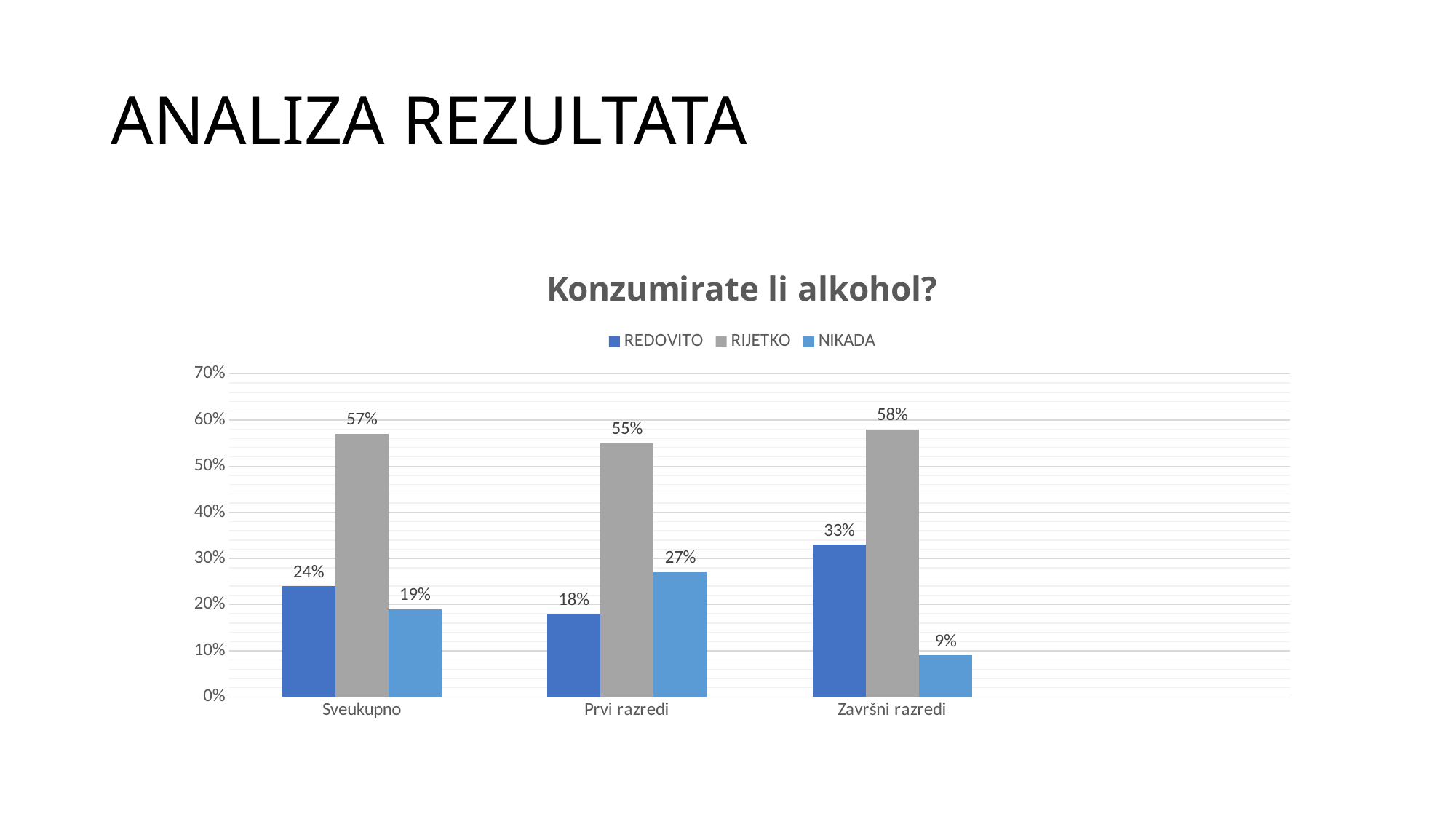
What is the difference between the REDOVITO values for Završni razredi and Prvi razredi? 15% What is the value for REDOVITO in the Završni razredi category? 33% Is the value for RIJETKO in Prvi razredi greater or less than 50%? greater How many series does the legend list? 3 What is the value for NIKADA in the Prvi razredi category? 27% What is the title of the chart? Konzumirate li alkohol? How many categories are shown on the x axis? 3 Which category has the highest value for REDOVITO? Završni razredi What kind of chart is shown on the slide? bar chart What is the value for RIJETKO in the Sveukupno category? 57% Which is larger: the NIKADA value for Sveukupno or the NIKADA value for Prvi razredi? Prvi razredi Which category has the lowest value for NIKADA? Završni razredi